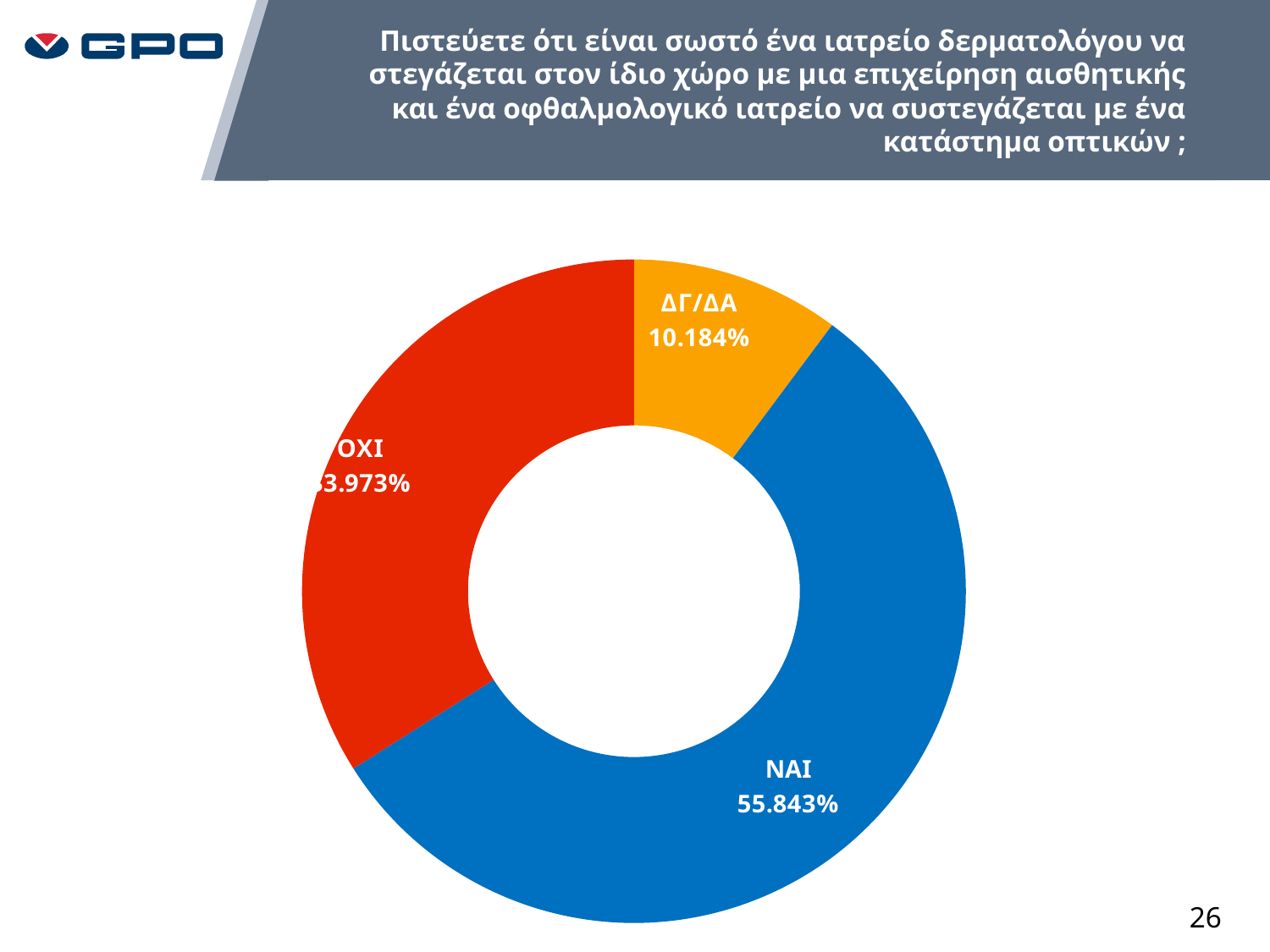
Which category has the smallest slice in the pie chart? ΔΓ/ΔΑ What colour is the ΔΓ/ΔΑ slice in the chart? orange What kind of chart is shown on the slide? doughnut chart Which slice is larger, ΟΧΙ or ΔΓ/ΔΑ? ΟΧΙ What share of the pie does the ΝΑΙ slice take? 55.843% What is the difference between the ΝΑΙ value and the ΔΓ/ΔΑ value? 45.659% What is the value shown for ΝΑΙ in the pie chart? 55.843% What is the value shown for ΔΓ/ΔΑ in the pie chart? 10.184% What colour is the ΝΑΙ slice in the chart? blue How many categories are shown in the pie chart? 3 Which slice is larger, ΝΑΙ or ΟΧΙ? ΝΑΙ Which category has the largest slice in the pie chart? ΝΑΙ